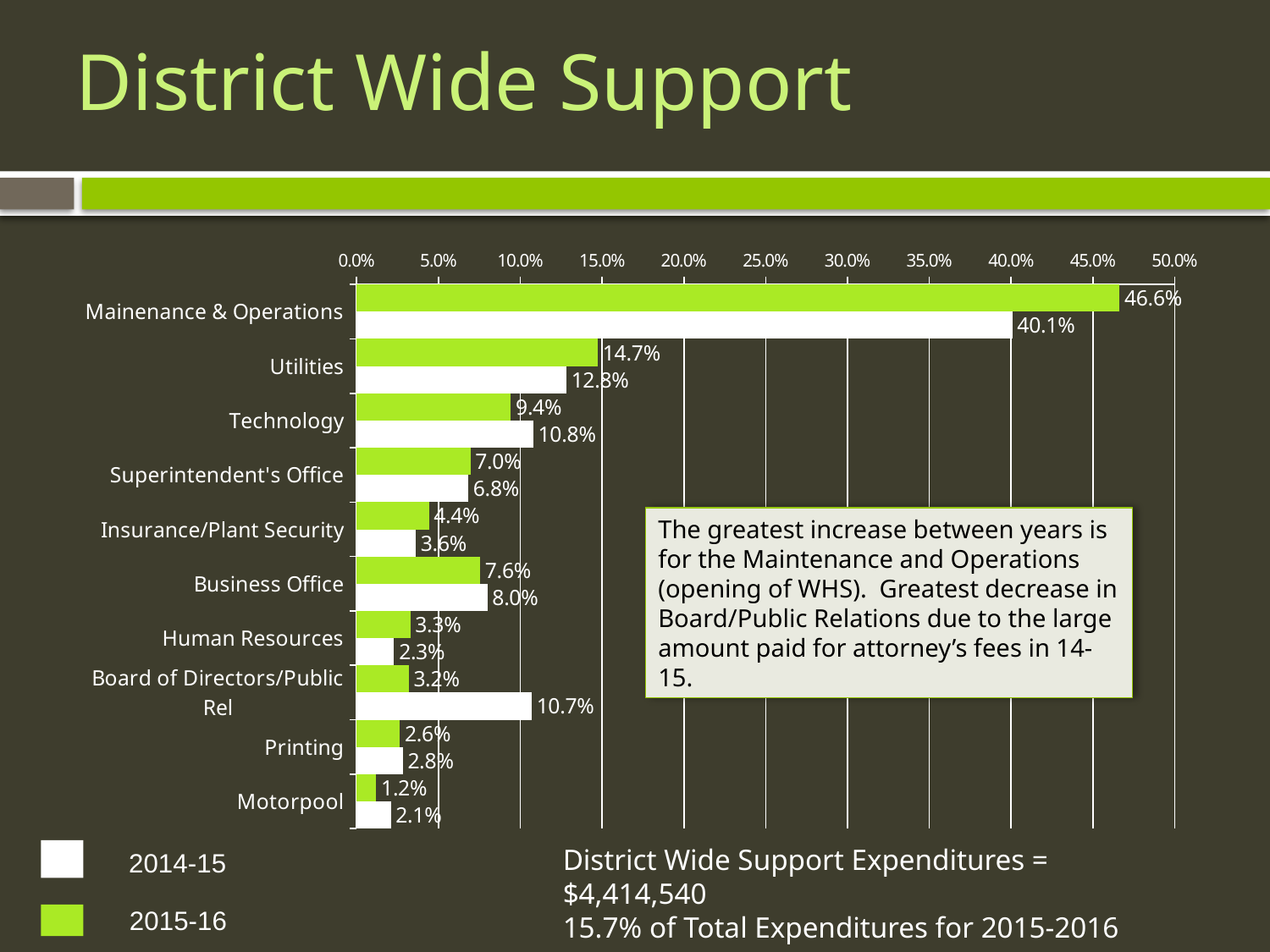
What is the 2015-16 value for Mainenance & Operations? 46.6% Which category has the lowest 2015-16 value? Motorpool What is the difference between the 2014-15 and 2015-16 values for Board of Directors/Public Rel? 7.5% Which is larger for Utilities, the 2014-15 value or the 2015-16 value? 2015-16 What is the difference between the 2015-16 and 2014-15 values for Mainenance & Operations? 6.5% Which category has the highest 2015-16 value? Mainenance & Operations Is the 2014-15 value for Mainenance & Operations greater or less than 35.0%? greater What kind of chart is shown on the slide? Bar chart How many categories are shown on the chart? 10 What is the 2014-15 value for Technology? 10.8% How many series does the legend list? 2 What is the 2014-15 value for Board of Directors/Public Rel? 10.7%